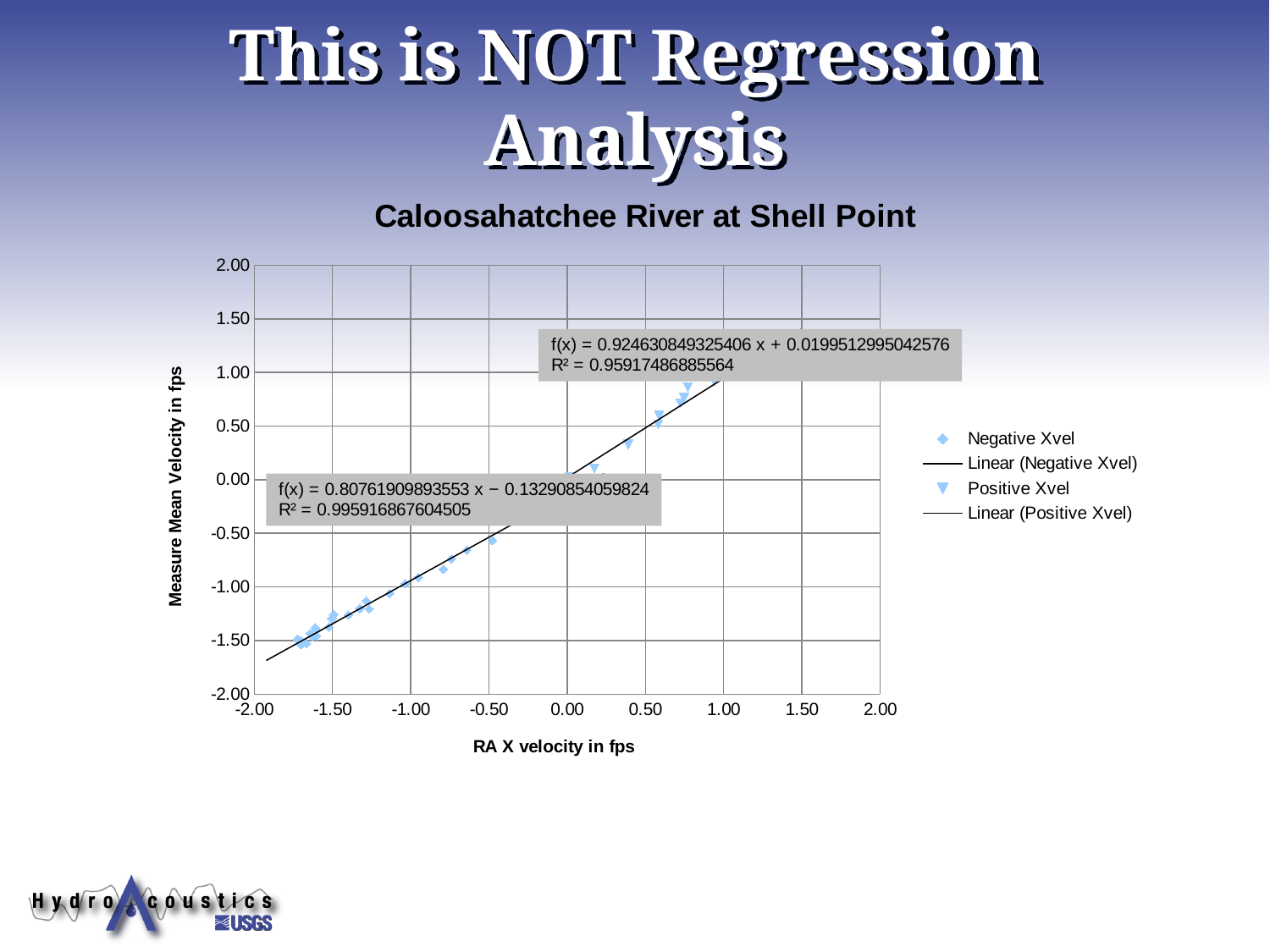
What is the slope shown in the trendline equation for Positive Xvel? 0.924630849325406 What kind of chart is shown on the slide? Scatter chart Which series has the higher R² value, Negative Xvel or Positive Xvel? Negative Xvel What is the label of the x axis? RA X velocity in fps How many entries does the chart legend list? 4 Are the Negative Xvel points near an RA X velocity of -1.50 greater or less than -1.00 on the y axis? less What is the R² value shown for the Negative Xvel trendline? 0.995916867604505 Are the Positive Xvel points near an RA X velocity of 0.75 greater or less than 0.50 on the y axis? greater Do the plotted values rise or fall as RA X velocity increases along the x axis? Rise What is the intercept shown in the trendline equation for Negative Xvel? −0.13290854059824 What is the title of the chart? Caloosahatchee River at Shell Point What is the R² value shown for the Positive Xvel trendline? 0.95917486885564